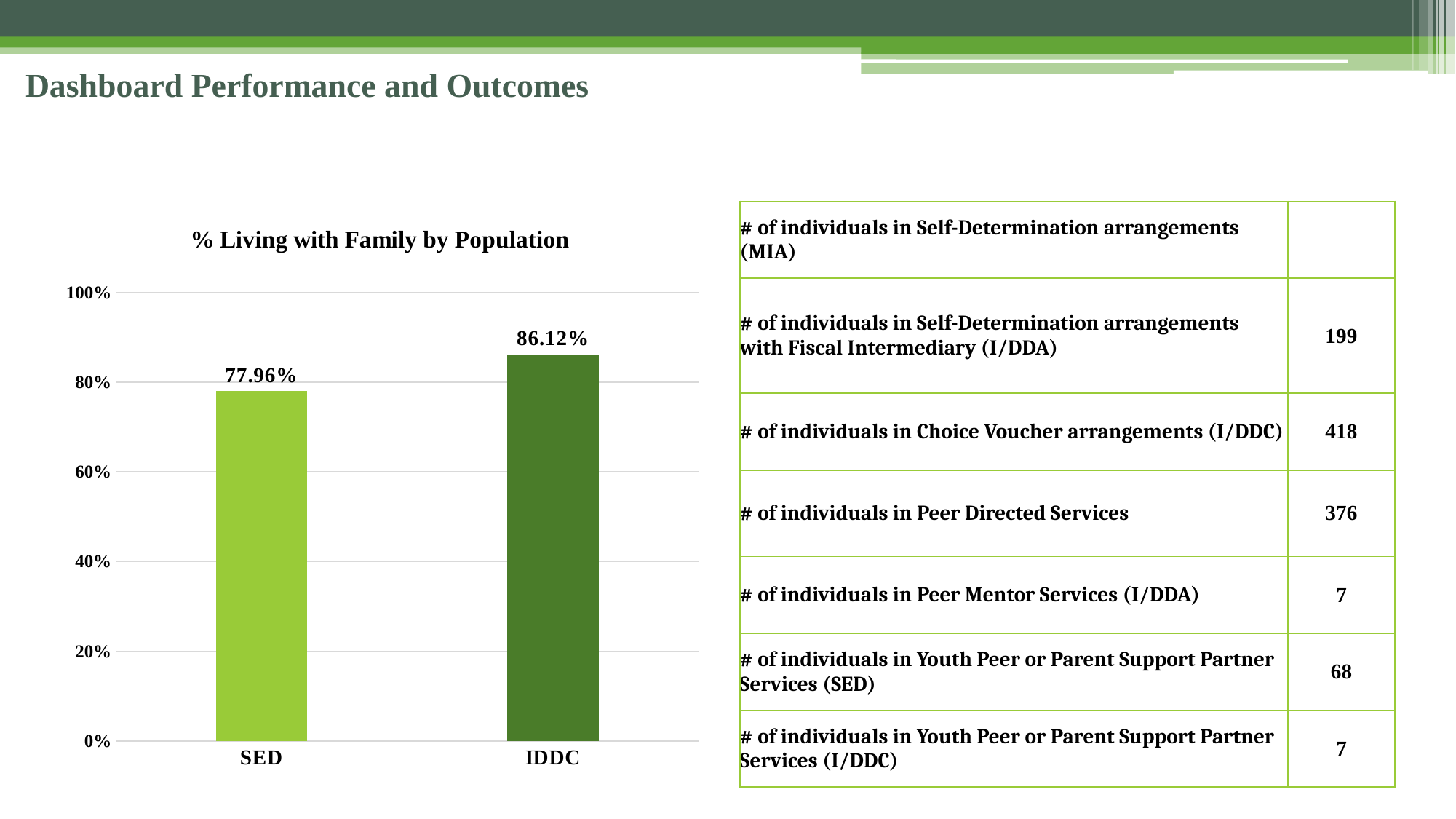
Is the value for IDDC greater or less than 80%? greater What is the difference between the IDDC and SED values in the '% Living with Family by Population' chart? 8.16% What is the value for IDDC in the '% Living with Family by Population' chart? 86.12% How many categories are shown in the '% Living with Family by Population' chart? 2 What is the value for SED in the '% Living with Family by Population' chart? 77.96% Is the value for SED greater or less than 80%? less Which is larger in the '% Living with Family by Population' chart, SED or IDDC? IDDC What is the highest value shown on the y axis of the '% Living with Family by Population' chart? 100% Which population has the highest % living with family? IDDC Which population has the lowest % living with family? SED What is the title of the chart on the slide? % Living with Family by Population What kind of chart is '% Living with Family by Population'? bar chart